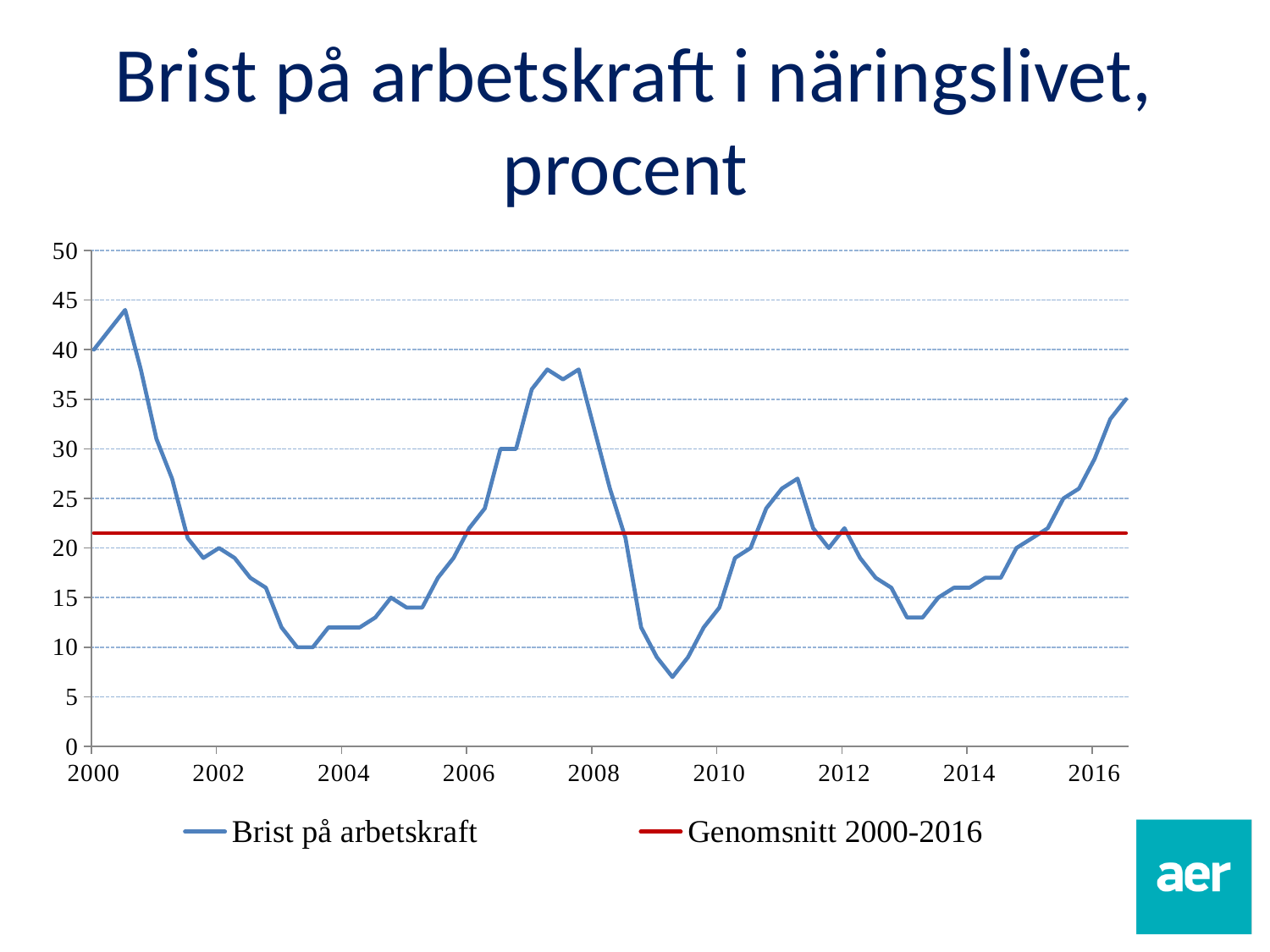
What kind of chart is shown on the slide? line chart How many series does the legend list? 2 What is the title of the chart? Brist på arbetskraft i näringslivet, procent Does the Brist på arbetskraft line rise or fall between 2014 and 2016? rise Does the Brist på arbetskraft line rise or fall between 2000 and 2002? fall Is the Genomsnitt 2000-2016 line greater or less than 25? less Is the value for Brist på arbetskraft at 2016 greater or less than 20? greater Is the value for Brist på arbetskraft at 2000 greater or less than 35? greater What does the red line in the chart represent, according to the legend? Genomsnitt 2000-2016 Which is larger, the value for Brist på arbetskraft at 2000 or at 2004? 2000